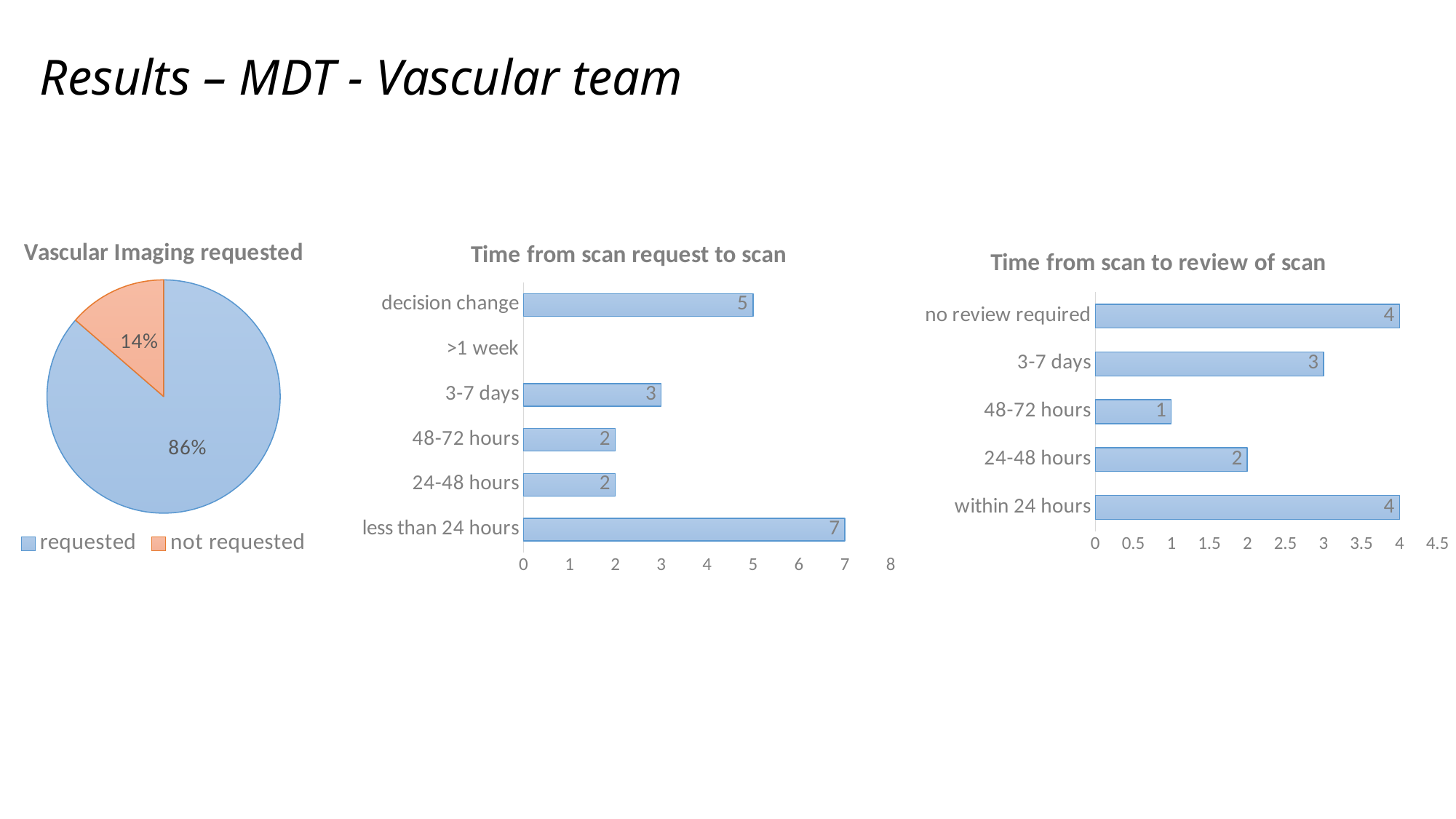
How many categories are listed on the y axis of the 'Time from scan request to scan' chart? 6 In the 'Vascular Imaging requested' chart, what share of the pie is 'not requested'? 14% In the 'Time from scan request to scan' chart, what is the value for 'decision change'? 5 In the 'Time from scan to review of scan' chart, which category has the lowest value? 48-72 hours In the 'Time from scan to review of scan' chart, which is larger: '24-48 hours' or '3-7 days'? 3-7 days In the 'Time from scan request to scan' chart, what is the value for 'less than 24 hours'? 7 In the 'Vascular Imaging requested' chart, what share of the pie is 'requested'? 86% In the 'Time from scan request to scan' chart, what is the difference between 'less than 24 hours' and '3-7 days'? 4 In the 'Time from scan request to scan' chart, which category has the highest value? less than 24 hours What kind of chart is 'Time from scan to review of scan'? bar chart In the 'Time from scan to review of scan' chart, what is the value for '3-7 days'? 3 What kind of chart is 'Vascular Imaging requested'? pie chart